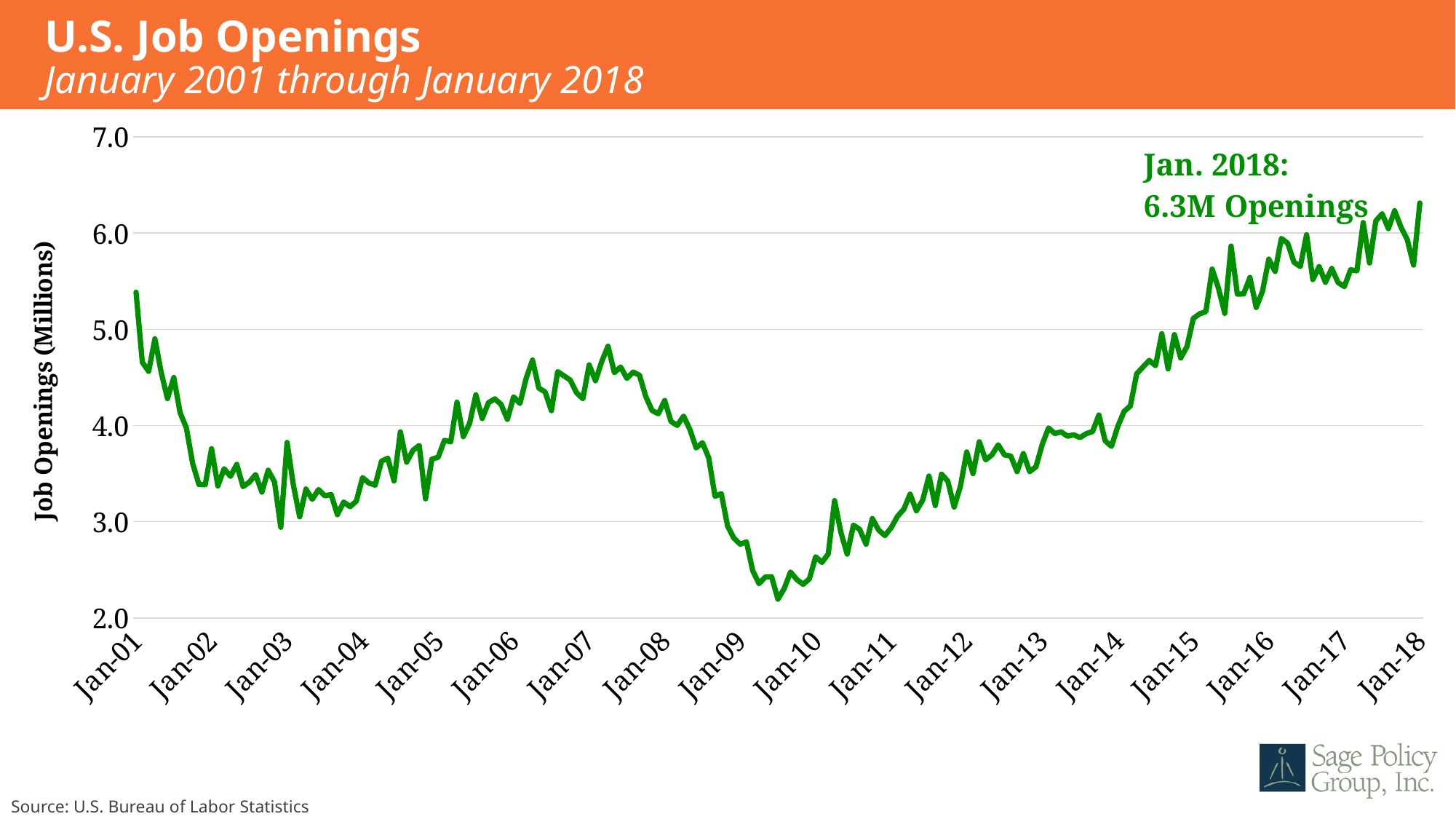
Is the value for Jan-03 greater or less than 4.0? less Do job openings rise or fall between Jan-10 and Jan-18? rise What is the label on the y axis of the chart? Job Openings (Millions) Is the value for Jan-10 greater or less than 3.0? less Which is larger, the value at Jan-18 or the value at Jan-01? Jan-18 Do job openings rise or fall between Jan-07 and Jan-09? fall Is the value for Jan-01 greater or less than 5.0? greater At which x-axis label does the line reach its highest point? Jan-18 Which is larger, the value at Jan-09 or the value at Jan-10? Jan-09 What kind of chart is shown on the slide? line chart What value is labelled for January 2018 on the chart? 6.3M Openings